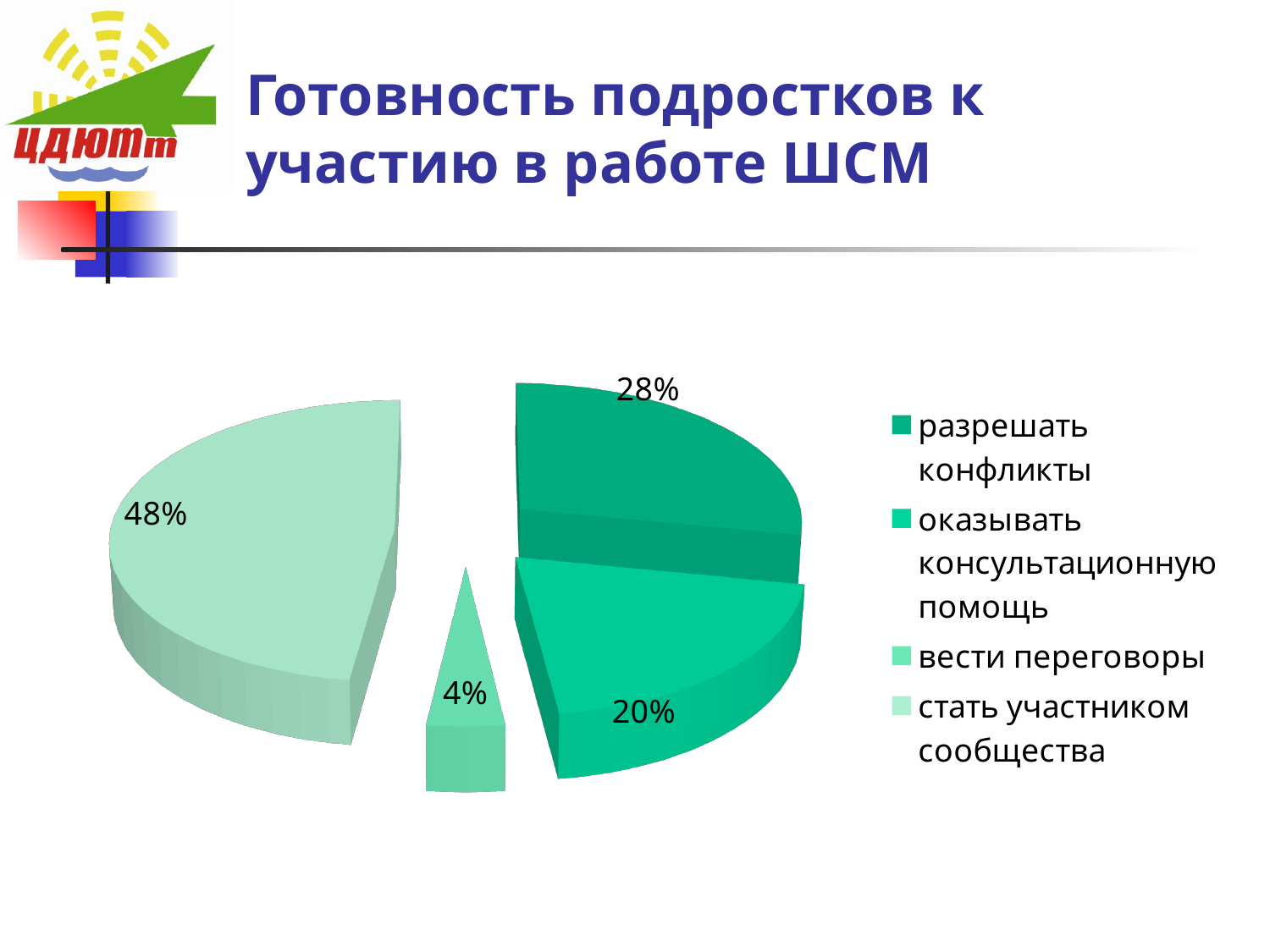
Which is larger: the share for "разрешать конфликты" or the share for "оказывать консультационную помощь"? разрешать конфликты What is the difference between the shares for "стать участником сообщества" and "разрешать конфликты"? 20% What share of the pie does "оказывать консультационную помощь" have? 20% What share of the pie does "разрешать конфликты" have? 28% What share of the pie does "стать участником сообщества" have? 48% What kind of chart is shown on the slide? pie chart Which category has the largest slice of the pie? стать участником сообщества What is the title of the slide containing the chart? Готовность подростков к участию в работе ШСМ How many entries does the legend list? 4 Which category has the smallest slice of the pie? вести переговоры How many slices does the pie chart have? 4 What share of the pie does "вести переговоры" have? 4%